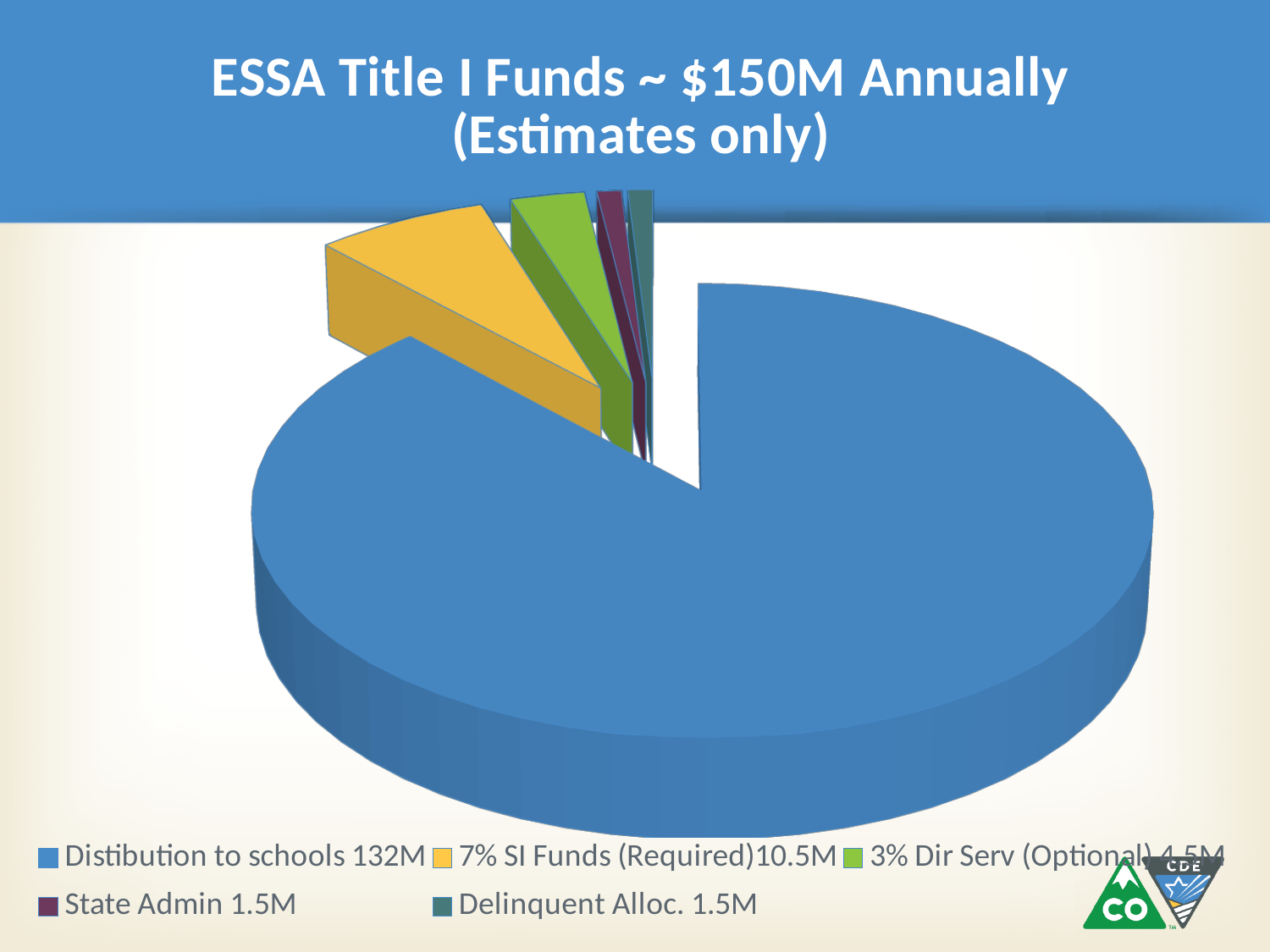
How many slices does the pie chart have? 5 What is the difference between Distibution to schools and 7% SI Funds (Required)? 121.5M Which is larger, 7% SI Funds (Required) or 3% Dir Serv (Optional)? 7% SI Funds (Required) What amount is shown for 7% SI Funds (Required)? 10.5M Which category has the largest slice of the pie? Distibution to schools What is the total of all the amounts listed in the legend? 150M What amount is shown for State Admin? 1.5M What kind of chart is shown on the slide? Pie chart What amount is shown for Delinquent Alloc.? 1.5M What colour is the slice for 7% SI Funds (Required)? Yellow What amount is shown for Distibution to schools? 132M What is the title of the chart on the slide? ESSA Title I Funds ~ $150M Annually (Estimates only)